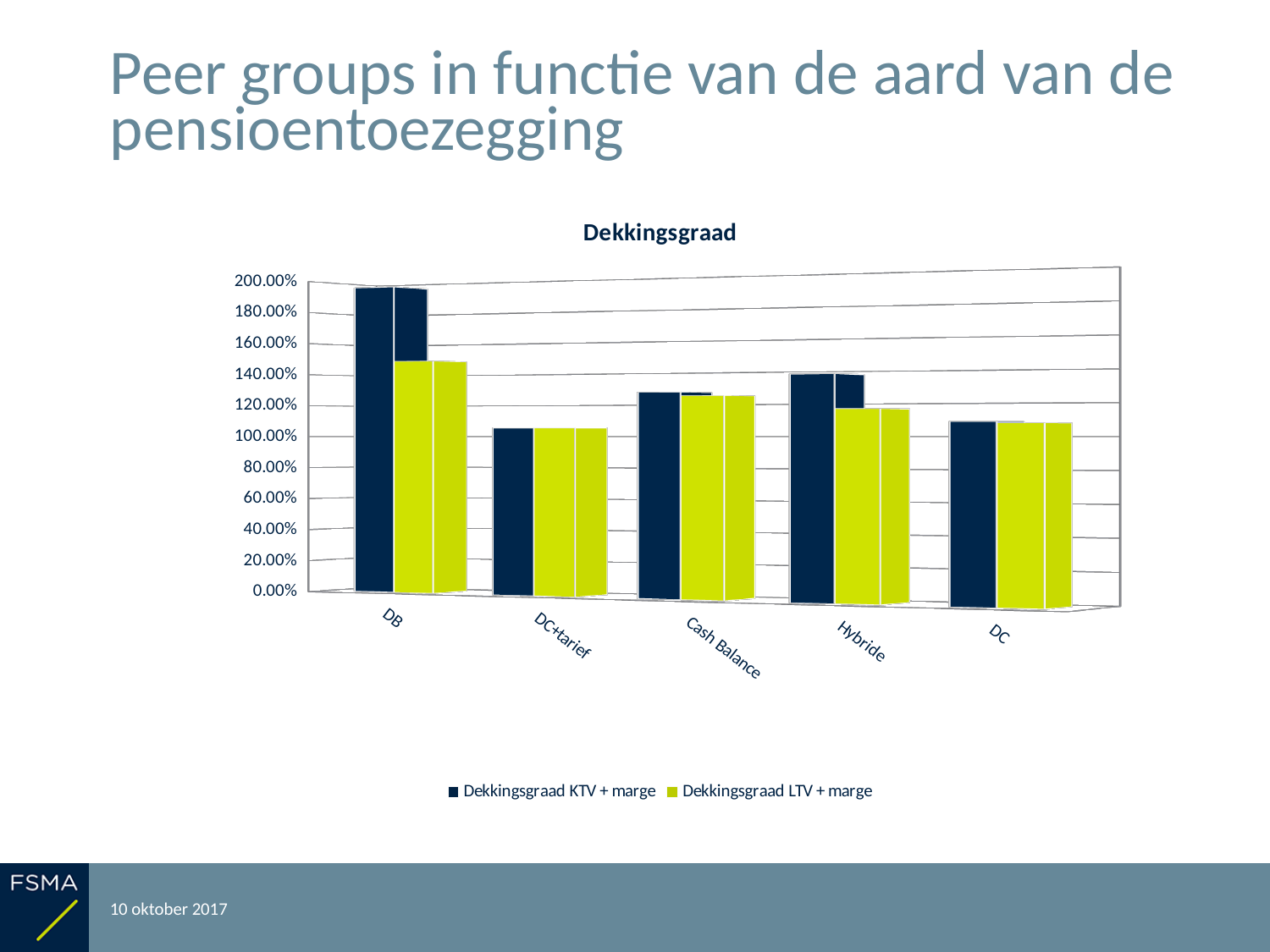
Is the Dekkingsgraad LTV + marge value for DB greater or less than 160.00%? less How many categories are shown on the x axis of the chart? 5 What kind of chart is shown on the slide? Bar chart Which category has the highest value for Dekkingsgraad LTV + marge? DB For DB, which is larger: Dekkingsgraad KTV + marge or Dekkingsgraad LTV + marge? Dekkingsgraad KTV + marge Which category has the highest value for Dekkingsgraad KTV + marge? DB What is the title of the chart? Dekkingsgraad Is the Dekkingsgraad KTV + marge value for DB greater or less than 180.00%? greater Which series is shown in dark navy bars? Dekkingsgraad KTV + marge Is the Dekkingsgraad KTV + marge value for Hybride greater or less than 120.00%? greater How many series does the legend list? 2